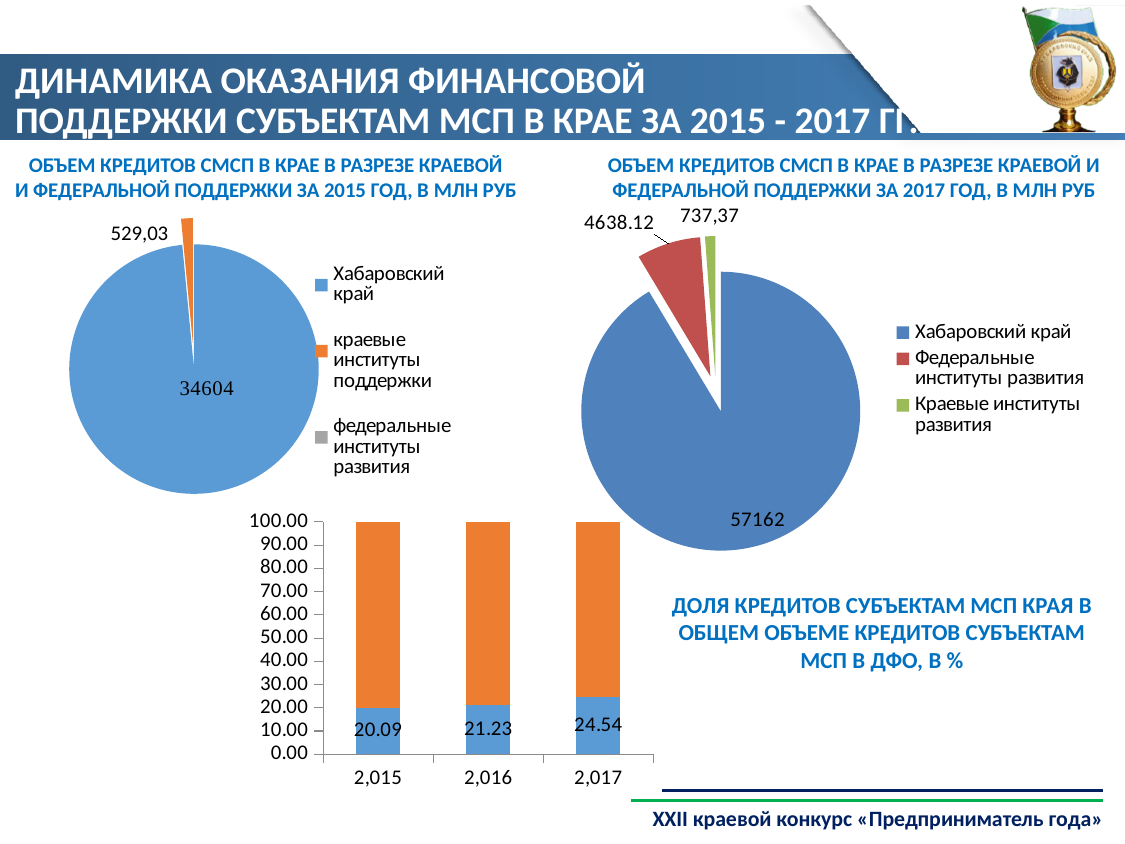
What type of chart is shown at the bottom of the slide? Stacked bar chart In the bar chart at the bottom, what is the difference between the labelled values for 2017 and 2015? 4.45 In the 2015 pie chart (left), what is the value for краевые институты поддержки? 529,03 In the 2017 pie chart (right), what is the value for Федеральные институты развития? 4638.12 In the 2017 pie chart (right), which is larger: Федеральные институты развития or Краевые институты развития? Федеральные институты развития In the 2017 pie chart (right), which category has the largest slice? Хабаровский край In the 2017 pie chart (right), what is the value for Краевые институты развития? 737,37 In the bar chart at the bottom, what is the labelled value for 2016? 21.23 In the 2015 pie chart (left), what is the value for Хабаровский край? 34604 In the 2015 pie chart (left), how many entries does the legend list? 3 In the bar chart at the bottom, do the labelled blue values rise or fall from 2015 to 2017? Rise In the 2017 pie chart (right), what colour is the slice for Хабаровский край? Blue